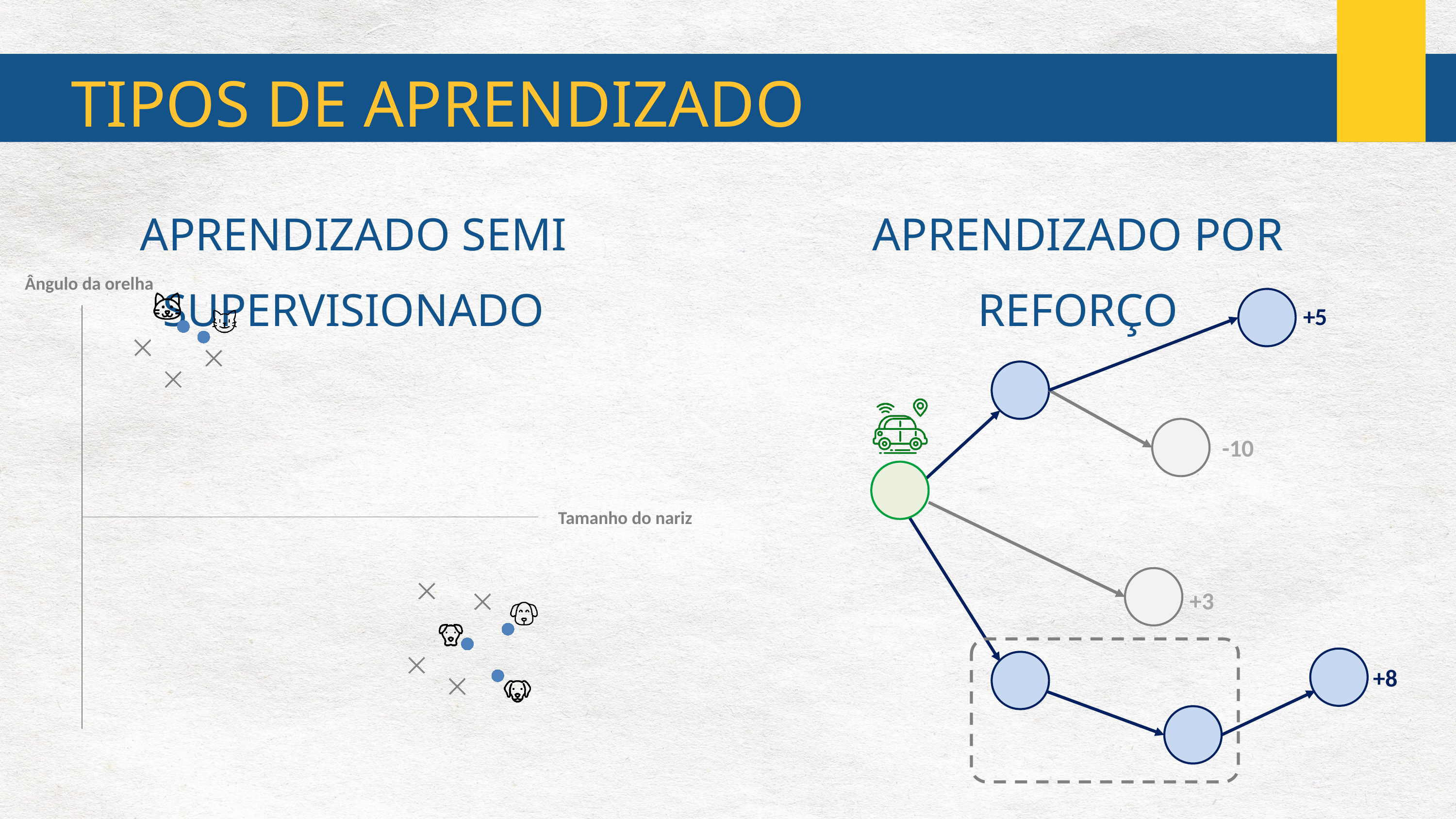
What kind of chart is shown on the left under 'Aprendizado semi supervisionado'? scatter chart On the left chart, how many X marks are plotted? 7 In the 'Aprendizado por reforço' diagram on the right, what reward value is shown at the end of the path inside the dashed box? +8 In the 'Aprendizado por reforço' diagram on the right, what is the highest reward value shown? +8 On the left chart, what is the label of the horizontal axis? Tamanho do nariz In the 'Aprendizado por reforço' diagram on the right, what is the difference between the highest reward (+8) and the lowest reward (-10)? 18 On the left chart, what is the label of the vertical axis? Ângulo da orelha In the 'Aprendizado por reforço' diagram on the right, how many reward values are labelled? 4 In the 'Aprendizado por reforço' diagram on the right, what is the lowest reward value shown? -10 On the left chart, how many blue dots are plotted? 5 In the 'Aprendizado por reforço' diagram on the right, which reward is larger, +5 or +3? +5